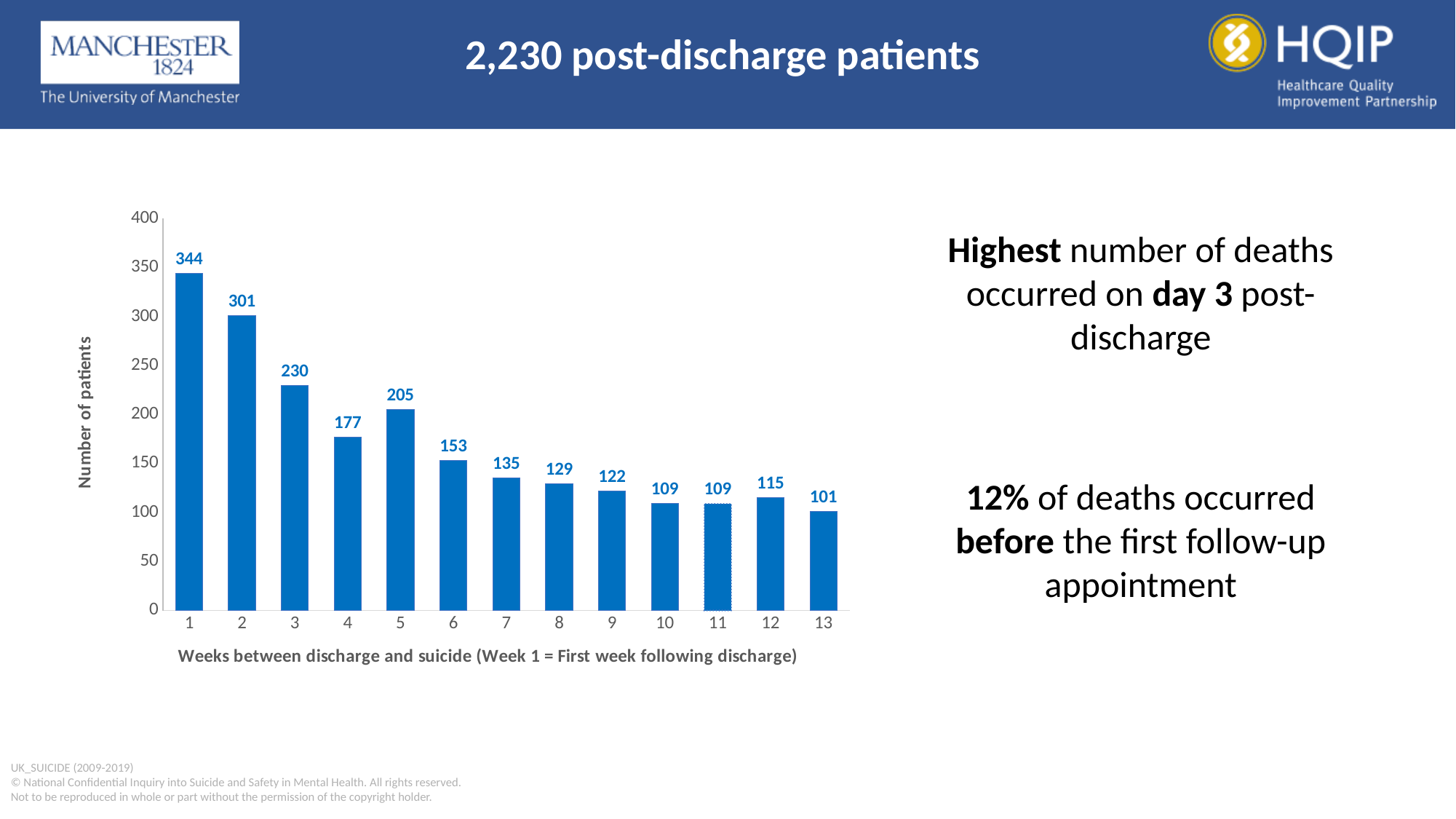
What is the difference in number of patients between week 3 and week 4? 53 How many weeks are shown on the x axis? 13 Which has more patients, week 4 or week 5? Week 5 What is the number of patients for week 13? 101 Which week has the lowest number of patients? Week 13 What is the number of patients for week 1? 344 What is the difference in number of patients between week 1 and week 2? 43 What kind of chart is shown on the slide? Bar chart Which week has the highest number of patients? Week 1 Is the value for week 6 greater or less than 150? greater What is the number of patients for week 5? 205 What is the label of the y axis? Number of patients